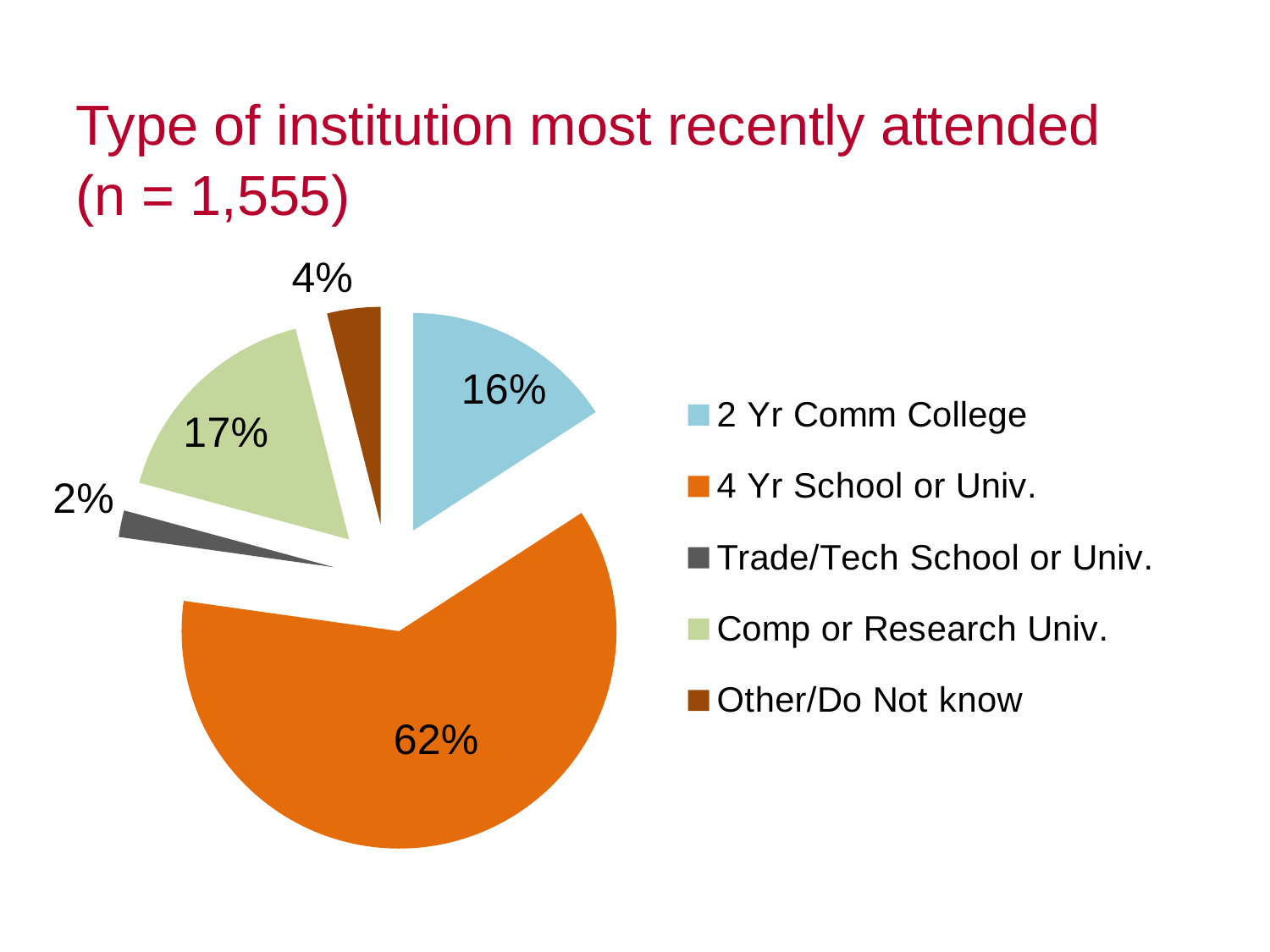
Which category has the smallest slice of the pie? Trade/Tech School or Univ. How many categories does the pie chart show? 5 What share of the pie is Trade/Tech School or Univ.? 2% Which category has the largest slice of the pie? 4 Yr School or Univ. What kind of chart is shown on the slide? Pie chart Which is larger, the share for 2 Yr Comm College or the share for Other/Do Not know? 2 Yr Comm College What share of the pie is 2 Yr Comm College? 16% What is the difference in percentage points between 4 Yr School or Univ. and Comp or Research Univ.? 45 What share of the pie is Comp or Research Univ.? 17% What is the sample size (n) given in the chart title? 1,555